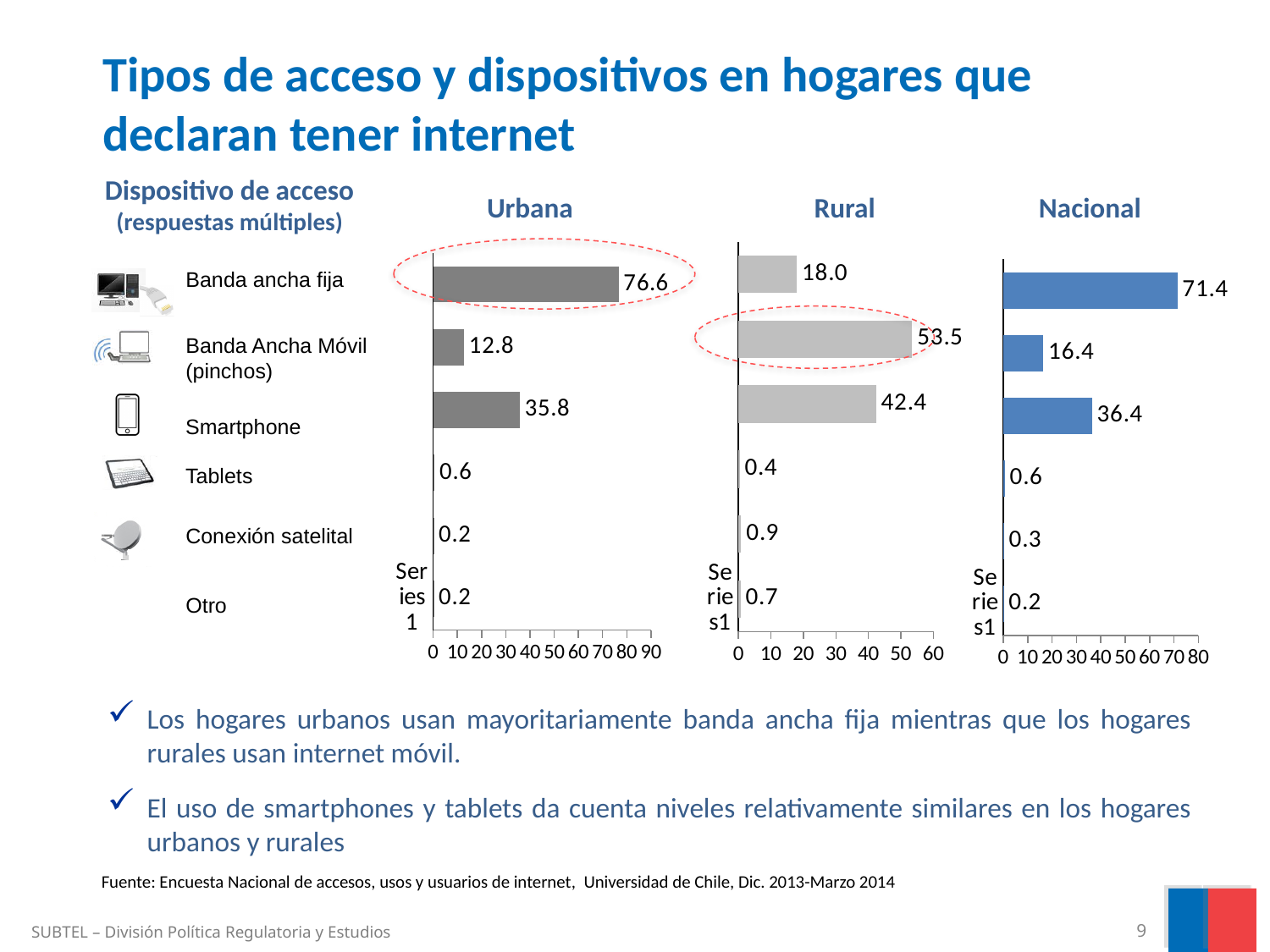
What are the titles of the three charts on the slide? Urbana, Rural, Nacional How many categories are shown in each of the three charts? 6 In the Nacional chart, what is the value for Smartphone? 36.4 In the Urbana chart, what is the value for Banda ancha fija? 76.6 In the Nacional chart, is the value for Banda ancha fija greater or less than 70? greater Which is larger: the Rural value for Smartphone or the Urbana value for Smartphone? Rural (42.4) In the Rural chart, which category has the highest value? Banda Ancha Móvil (pinchos) In the Urbana chart, which category has the highest value? Banda ancha fija In the Rural chart, what is the value for Banda Ancha Móvil (pinchos)? 53.5 What kind of chart is used for the Urbana, Rural and Nacional data? Bar chart In the Nacional chart, which category has the lowest value? Otro What is the difference between the Urbana and Rural values for Banda ancha fija? 58.6